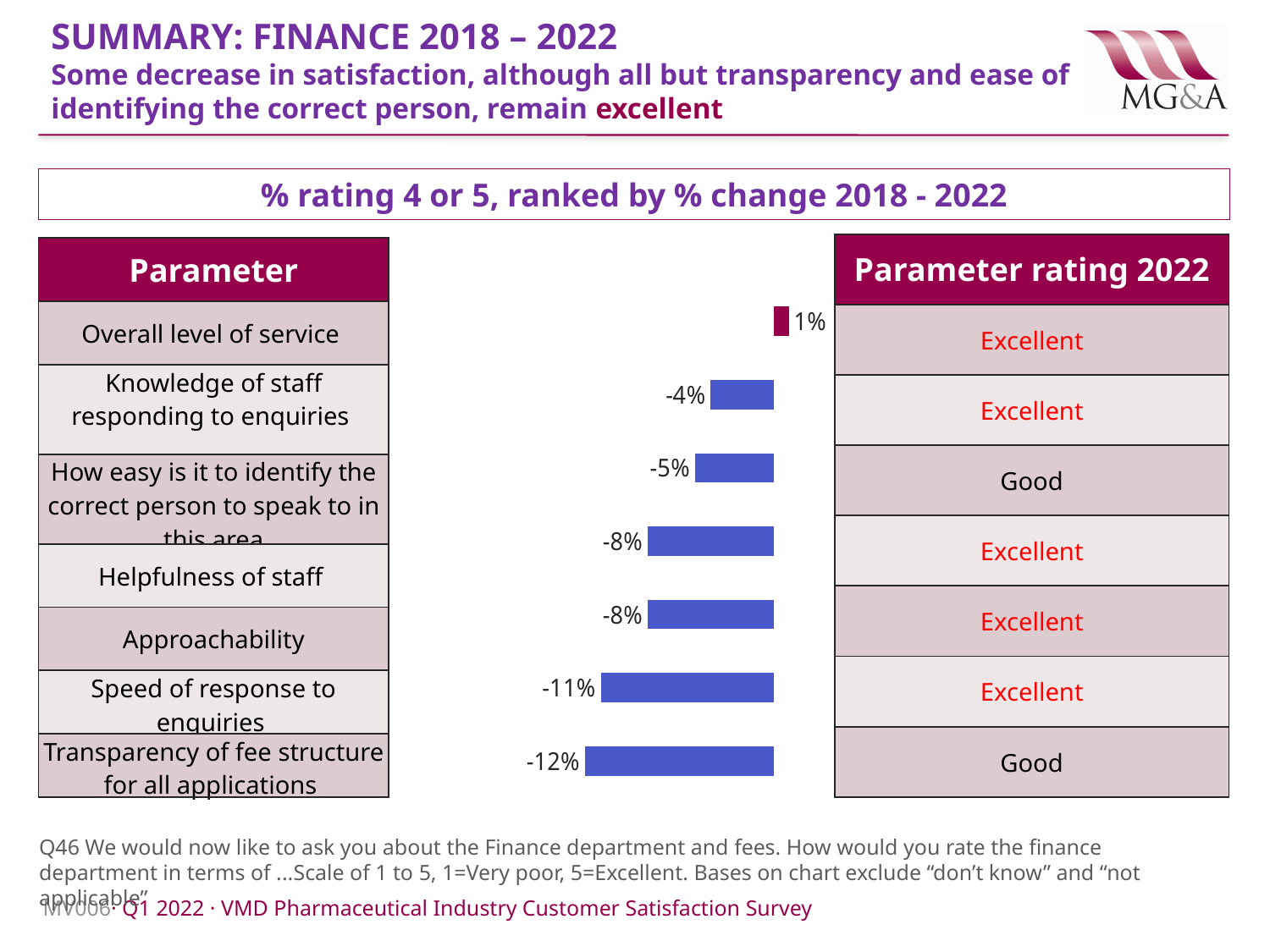
What is the difference between the % change for Knowledge of staff responding to enquiries and Speed of response to enquiries? 7 percentage points Which has a larger % change 2018 - 2022: Helpfulness of staff or Transparency of fee structure for all applications? Helpfulness of staff What kind of chart is shown on the slide? Bar chart What is the % change 2018 - 2022 for Overall level of service? 1% What is the Parameter rating 2022 for Approachability? Excellent What is the % change 2018 - 2022 for Knowledge of staff responding to enquiries? -4% What is the % change 2018 - 2022 for Speed of response to enquiries? -11% What is the % change 2018 - 2022 for Transparency of fee structure for all applications? -12% Which parameter has the lowest % change 2018 - 2022? Transparency of fee structure for all applications How many parameters are plotted in the chart? 7 Which parameter has the highest % change 2018 - 2022? Overall level of service What is the title of the chart? % rating 4 or 5, ranked by % change 2018 - 2022